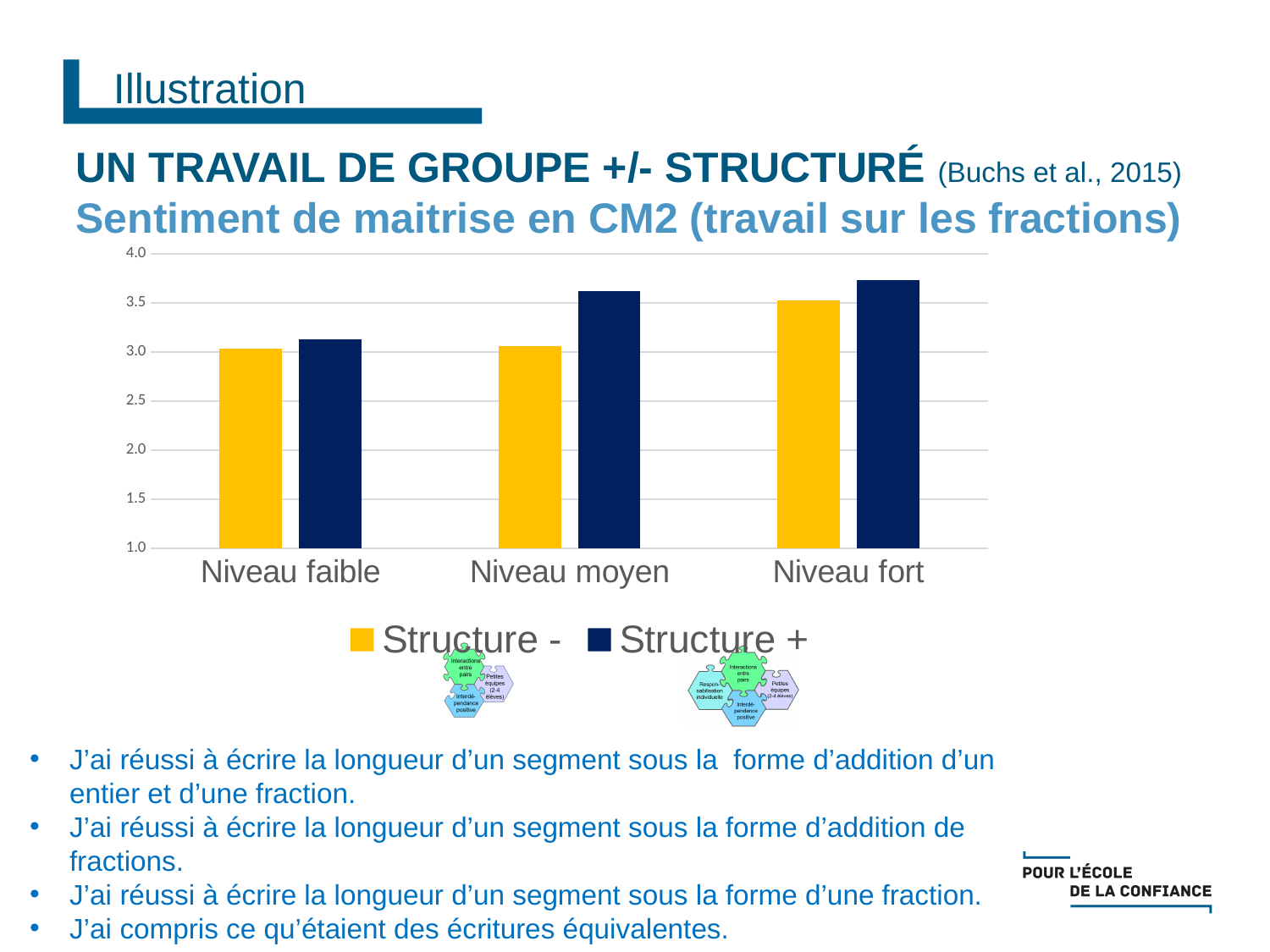
Is the value for Structure - at Niveau moyen greater or less than 3.5? less Which category has the lowest value for the Structure + series? Niveau faible Which category has the highest value for the Structure - series? Niveau fort Which colour represents the Structure - series in the chart? Yellow What kind of chart is shown on the slide? Bar chart How many categories (niveaux) are shown on the x axis of the chart? 3 For Niveau moyen, which series has the larger value, Structure - or Structure +? Structure + For Niveau fort, which series has the larger value, Structure - or Structure +? Structure + How many series does the chart legend list? 2 Is the value for Structure + at Niveau moyen greater or less than 3.5? greater Do the Structure + values rise or fall from Niveau faible to Niveau fort? rise Which category has the highest value for the Structure + series? Niveau fort